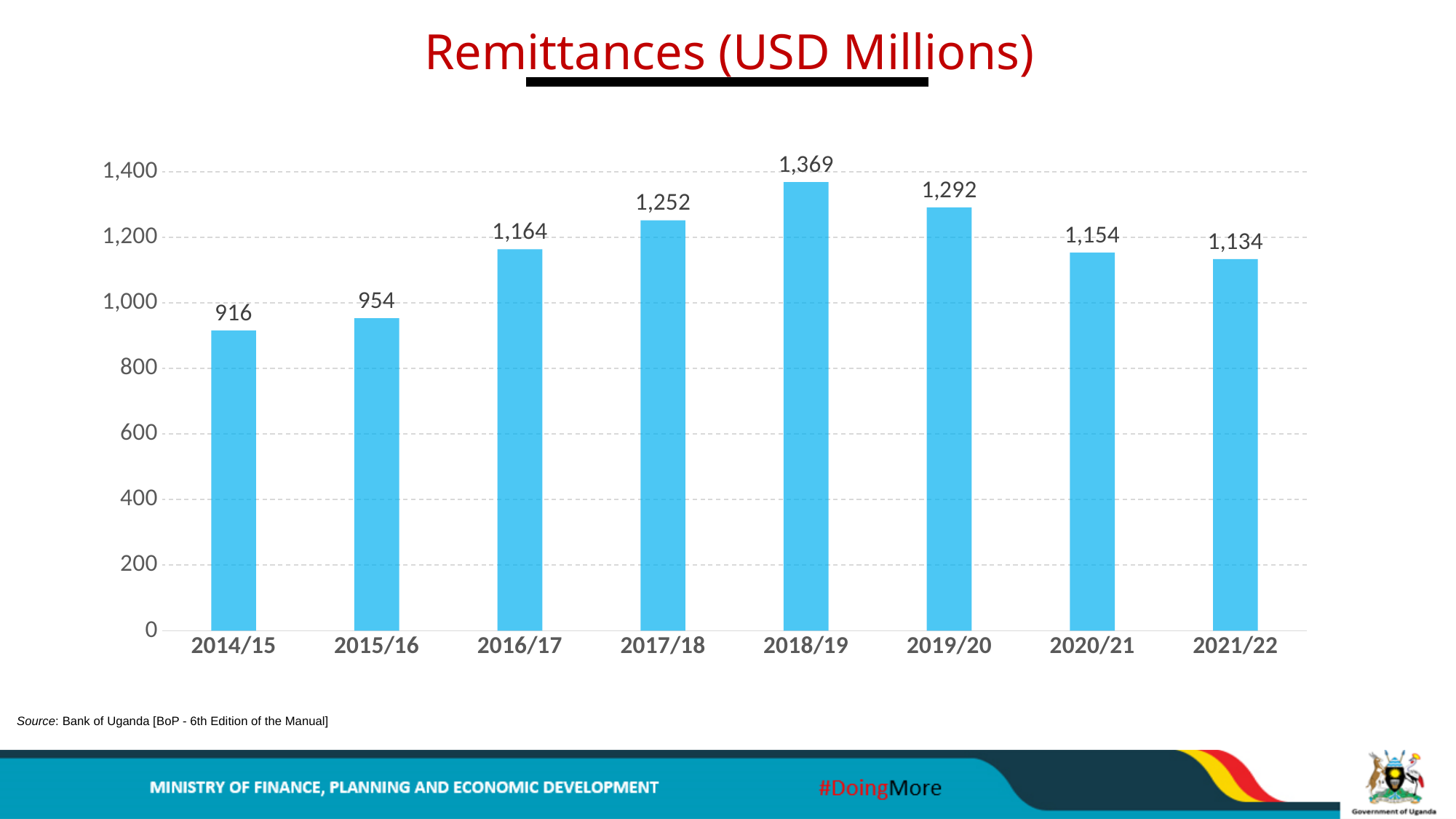
What is the remittances value for 2018/19? 1,369 Which year has the lowest remittances? 2014/15 Do remittances rise or fall from 2014/15 to 2018/19? Rise What is the difference in remittances between 2015/16 and 2014/15? 38 Which year has higher remittances, 2017/18 or 2020/21? 2017/18 What is the remittances value for 2014/15? 916 Is the value for 2016/17 greater or less than 1,000? greater What kind of chart is shown on the slide? Bar chart How many years are shown on the x axis? 8 Which year has the highest remittances? 2018/19 What is the remittances value for 2021/22? 1,134 What is the difference in remittances between 2018/19 and 2019/20? 77